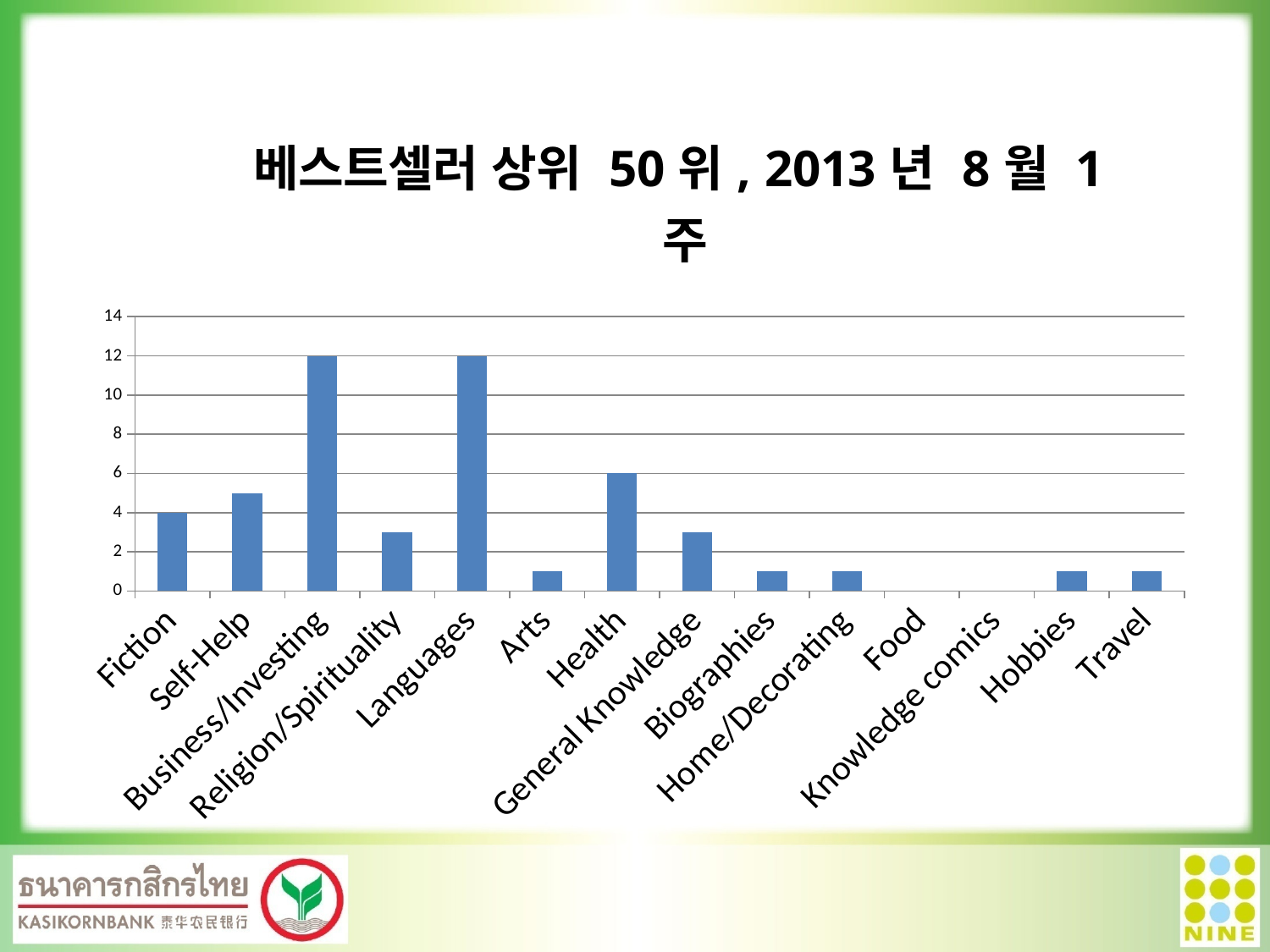
What kind of chart is shown on the slide? Bar chart What is the value for Food? 0 What is the difference between the values for Health and Fiction? 2 How many categories are shown on the x axis? 14 Is the value for Religion/Spirituality greater or less than 4? less Is the value for Arts greater or less than 2? less What is the value for Fiction? 4 Is the value for Self-Help greater or less than 4? greater What is the value for Health? 6 Which is larger, the value for Health or the value for Fiction? Health What is the value for Languages? 12 What is the value for Business/Investing? 12